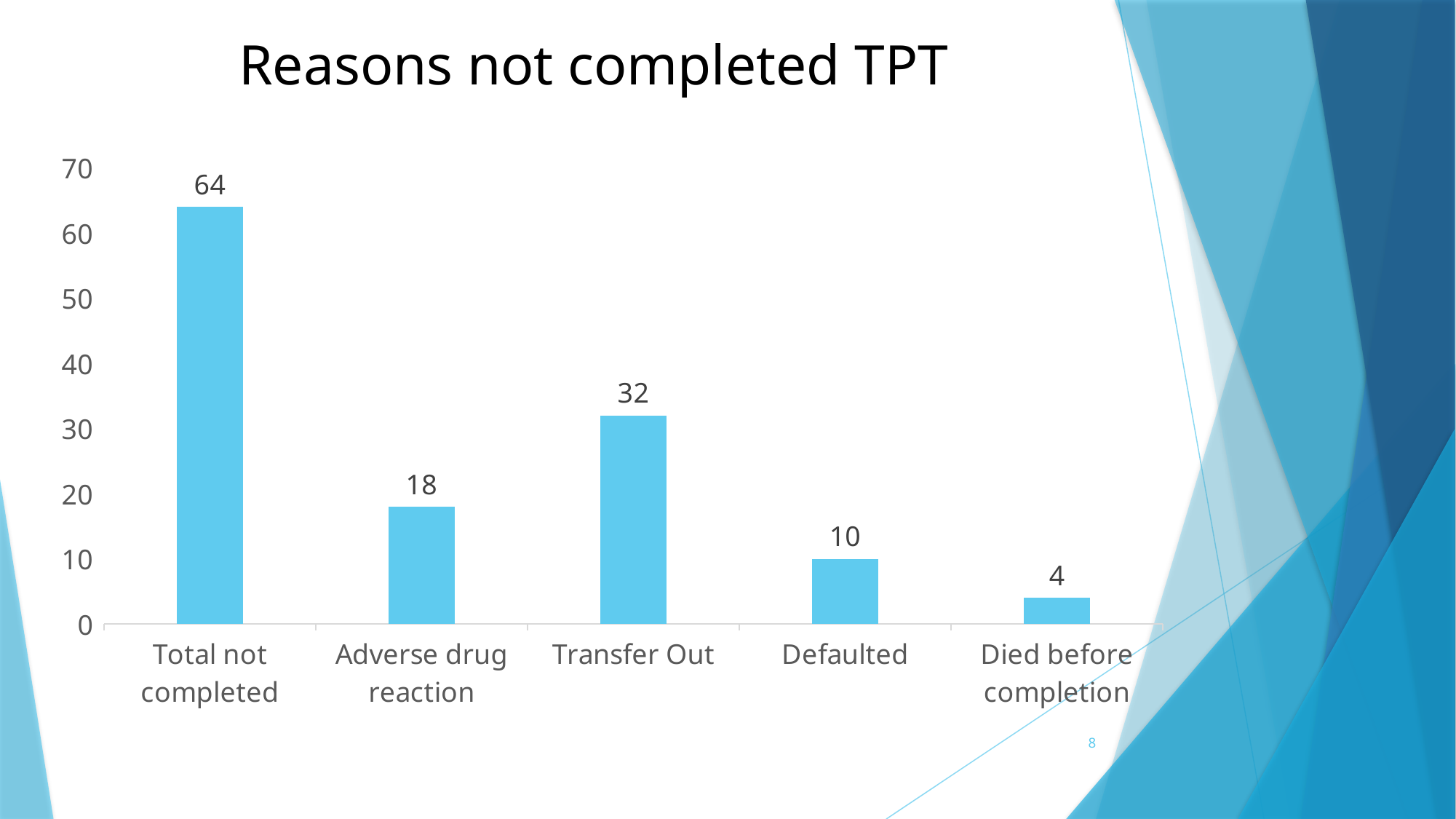
What is the difference between the values for Transfer Out and Adverse drug reaction? 14 Which category has the highest value? Total not completed What is the title of the chart? Reasons not completed TPT What is the value for Transfer Out? 32 What is the value for Adverse drug reaction? 18 What kind of chart is shown on the slide? bar chart What is the value for Defaulted? 10 What is the value for Died before completion? 4 How many categories are shown on the x axis? 5 Which is larger, the value for Defaulted or the value for Adverse drug reaction? Adverse drug reaction Which category has the lowest value? Died before completion Is the value for Total not completed greater or less than 60? greater